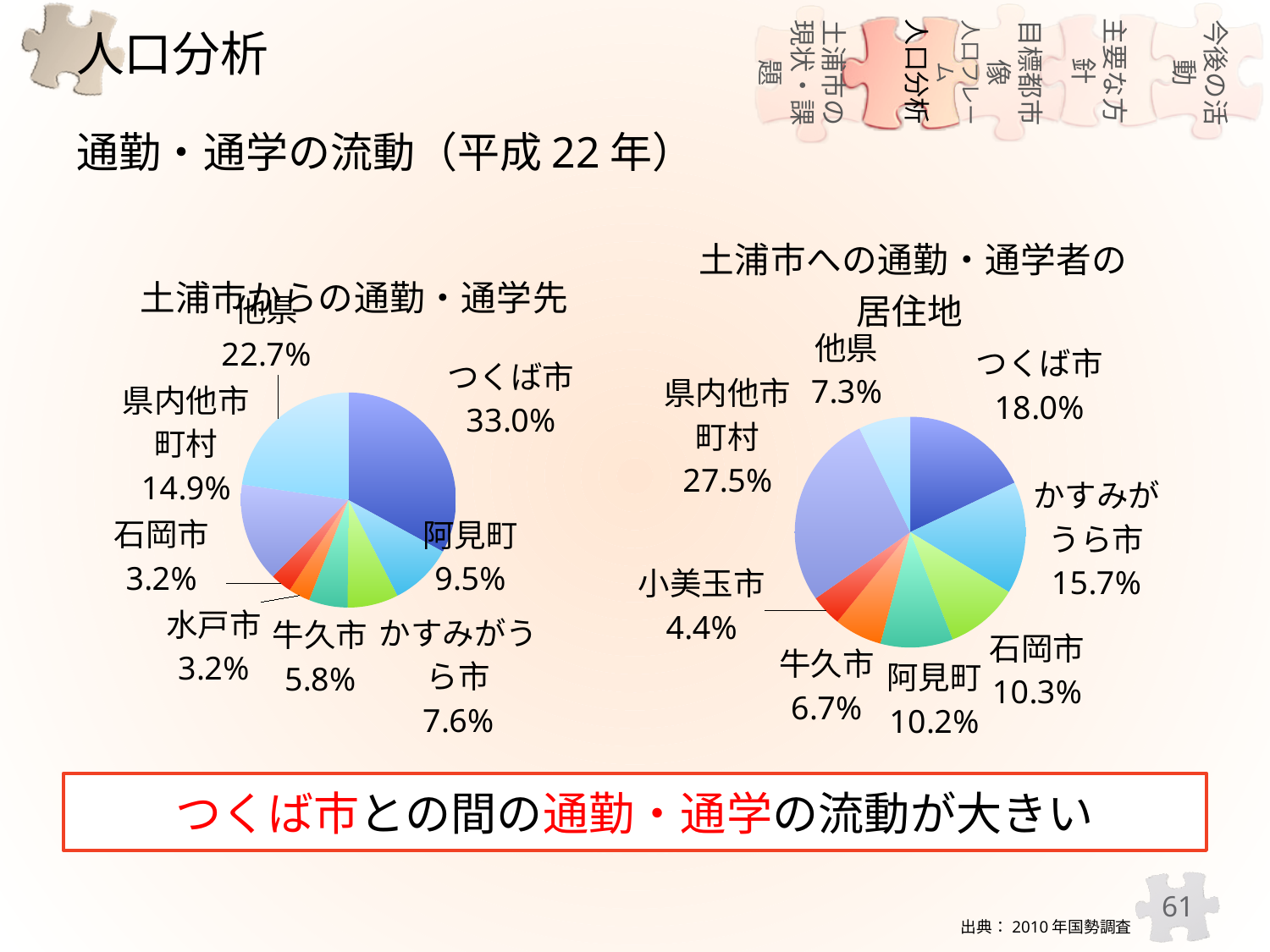
How many categories are shown in the left pie chart (土浦市からの通勤・通学先)? 8 What is the title of the left pie chart? 土浦市からの通勤・通学先 In the right pie chart (土浦市への通勤・通学者の居住地), which category has the smallest share? 小美玉市 In the right pie chart (土浦市への通勤・通学者の居住地), what share is labelled for 他県? 7.3% In the left pie chart (土浦市からの通勤・通学先), what share is labelled for 牛久市? 5.8% In the right pie chart (土浦市への通勤・通学者の居住地), which is larger: the share for 石岡市 or the share for 阿見町? 石岡市 In the left pie chart (土浦市からの通勤・通学先), what share is labelled for つくば市? 33.0% In the right pie chart (土浦市への通勤・通学者の居住地), what share is labelled for 県内他市町村? 27.5% In the left pie chart (土浦市からの通勤・通学先), what is the difference in percentage points between 他県 and 県内他市町村? 7.8 How many categories are shown in the right pie chart (土浦市への通勤・通学者の居住地)? 8 What type of chart is used for 土浦市への通勤・通学者の居住地? Pie chart In the left pie chart (土浦市からの通勤・通学先), which category has the largest share? つくば市